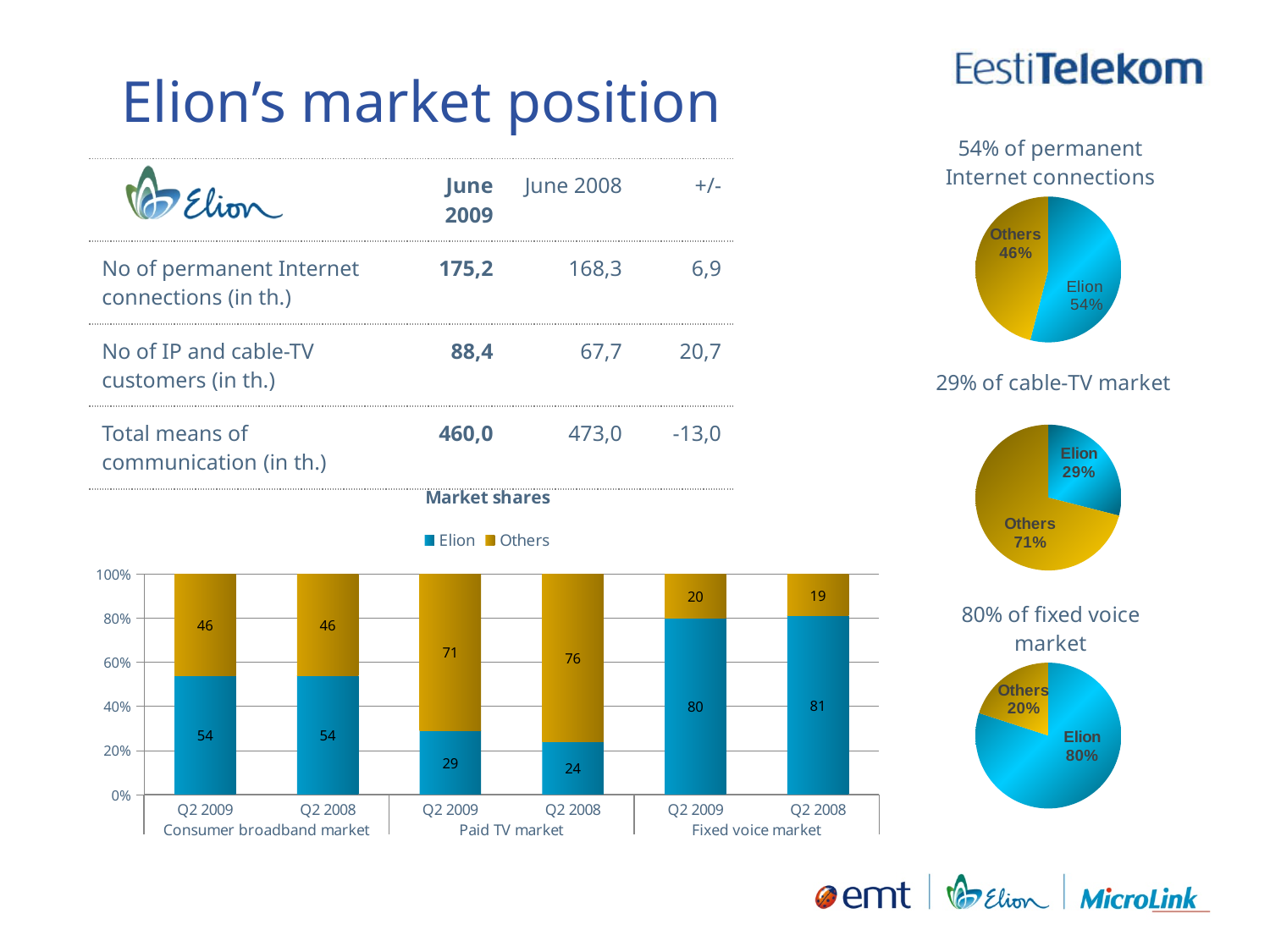
In the 'Market shares' bar chart, which bar has the lowest Elion value? Q2 2008, Paid TV market In the 'Market shares' bar chart, what is the difference between the Others values for Q2 2008 and Q2 2009 in the Paid TV market? 5 In the pie chart titled '80% of fixed voice market', what share does Others hold? 20% In the 'Market shares' bar chart, is the Elion value for Q2 2009 in the Fixed voice market larger or smaller than the Elion value for Q2 2009 in the Paid TV market? larger In the 'Market shares' bar chart, what is the Elion value for Q2 2009 in the Consumer broadband market? 54 What kind of chart is the 'Market shares' chart? Stacked bar chart In the 'Market shares' bar chart, what is the Others value for Q2 2008 in the Fixed voice market? 19 In the 'Market shares' bar chart, what is the Elion value for Q2 2009 in the Paid TV market? 29 How many bars are shown in the 'Market shares' bar chart? 6 How many series does the legend of the 'Market shares' bar chart list? 2 In the 'Market shares' bar chart, which bar has the highest Elion value? Q2 2008, Fixed voice market In the pie chart titled '29% of cable-TV market', what share does Others hold? 71%